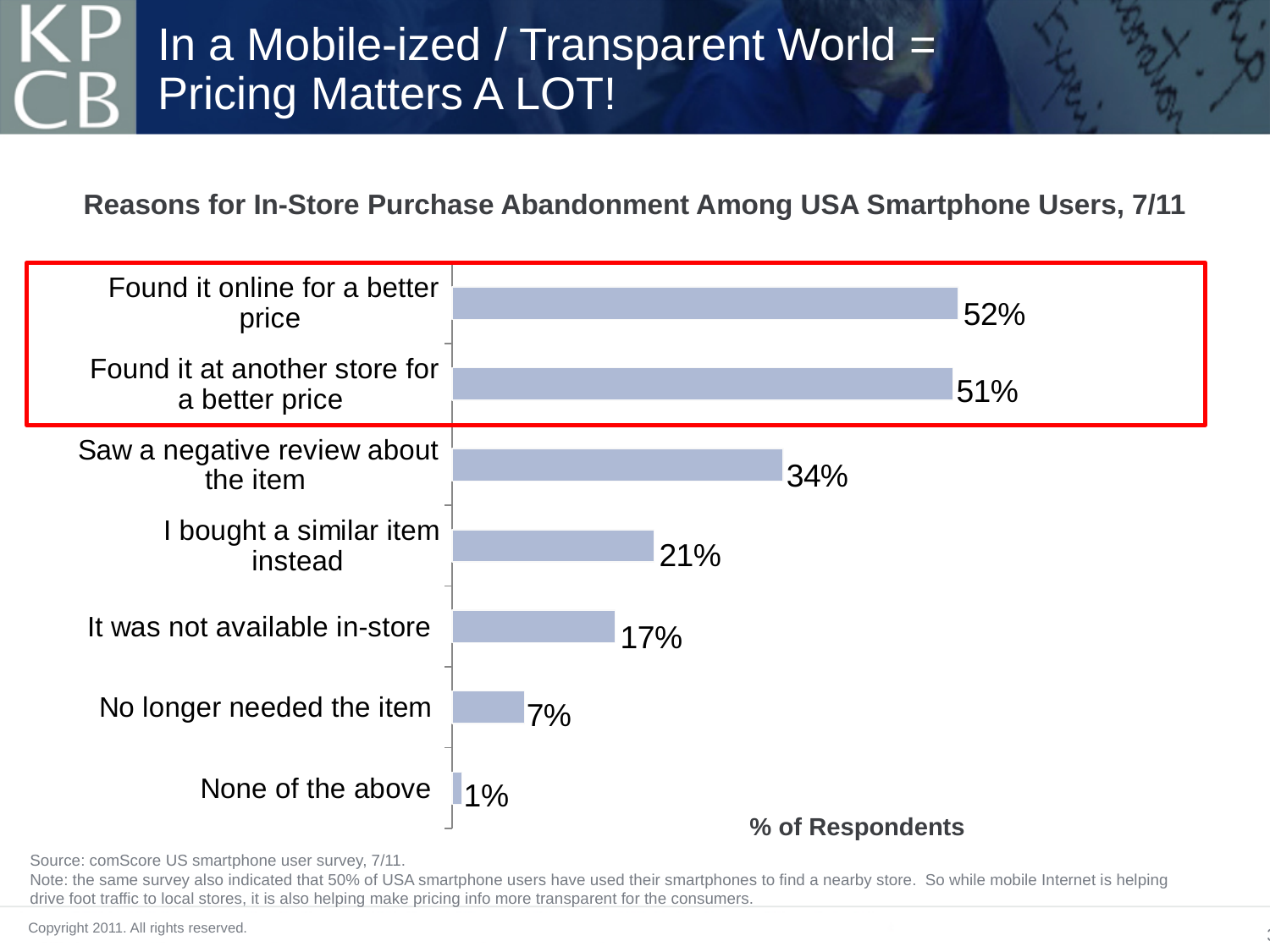
What is the difference between 'Found it online for a better price' and 'Saw a negative review about the item'? 18% What kind of chart is shown on the slide? Bar chart What is the value for 'It was not available in-store'? 17% What is the difference between 'I bought a similar item instead' and 'It was not available in-store'? 4% Which is larger: 'Saw a negative review about the item' or 'I bought a similar item instead'? Saw a negative review about the item What is the value for 'No longer needed the item'? 7% What is the title of the chart? Reasons for In-Store Purchase Abandonment Among USA Smartphone Users, 7/11 Which reason has the highest percentage of respondents? Found it online for a better price Which reason has the lowest percentage of respondents? None of the above What percentage of respondents said they found it online for a better price? 52% What percentage of respondents said they saw a negative review about the item? 34% How many reasons (categories) are shown in the chart? 7